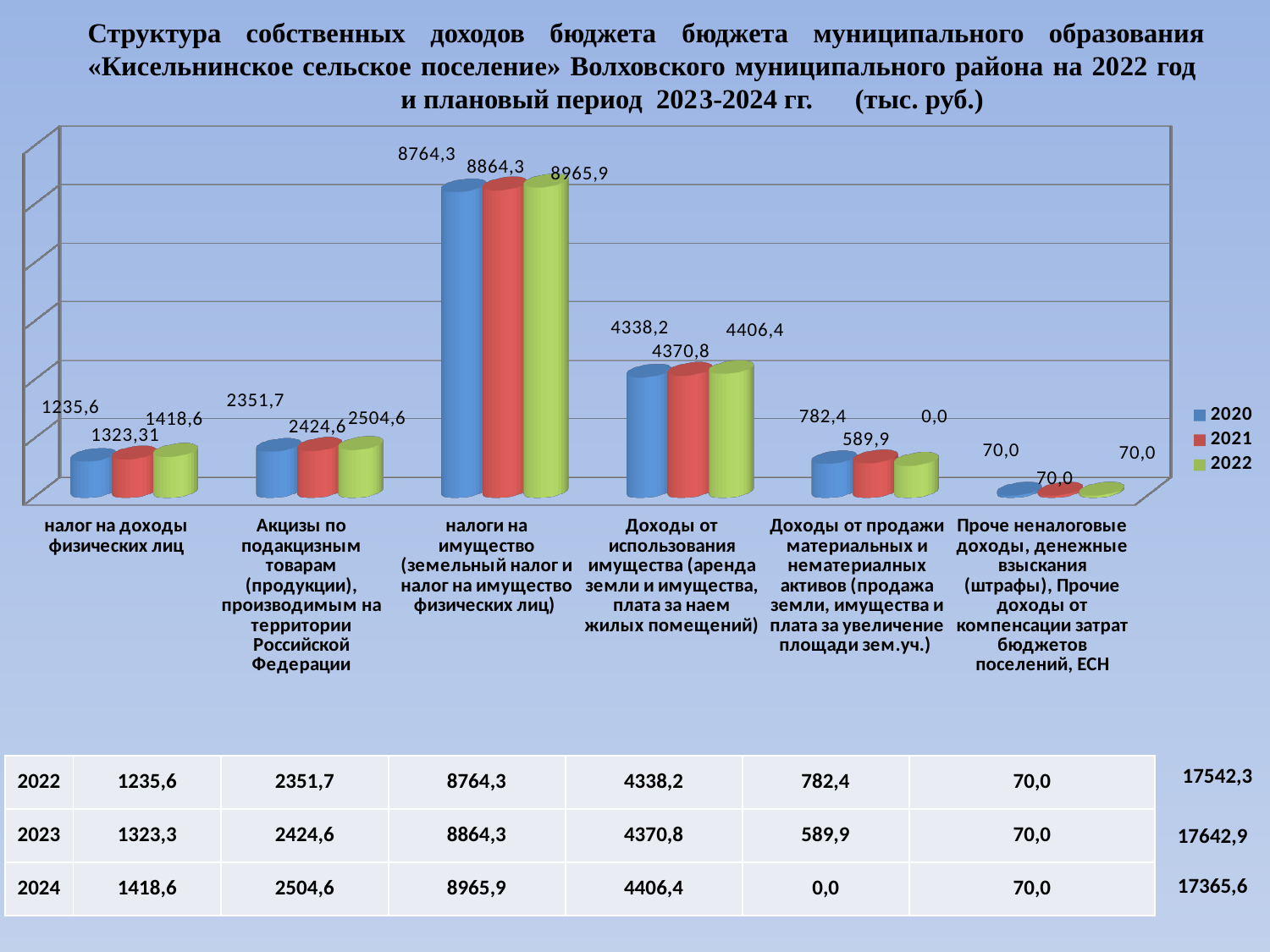
What kind of chart is shown on the slide? bar chart What is the 2022 value for «налоги на имущество (земельный налог и налог на имущество физических лиц)»? 8965,9 Which category has the lowest value in the 2020 series? Прочие неналоговые доходы, денежные взыскания (штрафы), Прочие доходы от компенсации затрат бюджетов поселений, ЕСН For «Доходы от продажи материальных и нематериальных активов», which series has the larger value, 2020 or 2021? 2020 What is the difference between the 2022 and 2020 values for «налоги на имущество»? 201,6 What is the difference between the 2021 and 2020 values for «Акцизы по подакцизным товарам»? 72,9 What are the entries listed in the chart legend? 2020, 2021, 2022 Which category has the highest value in the 2021 series? налоги на имущество (земельный налог и налог на имущество физических лиц) What is the 2020 value for «налог на доходы физических лиц»? 1235,6 How many categories are shown along the x axis of the chart? 6 How many series does the chart legend list? 3 What is the 2022 value for «Доходы от продажи материальных и нематериальных активов»? 0,0